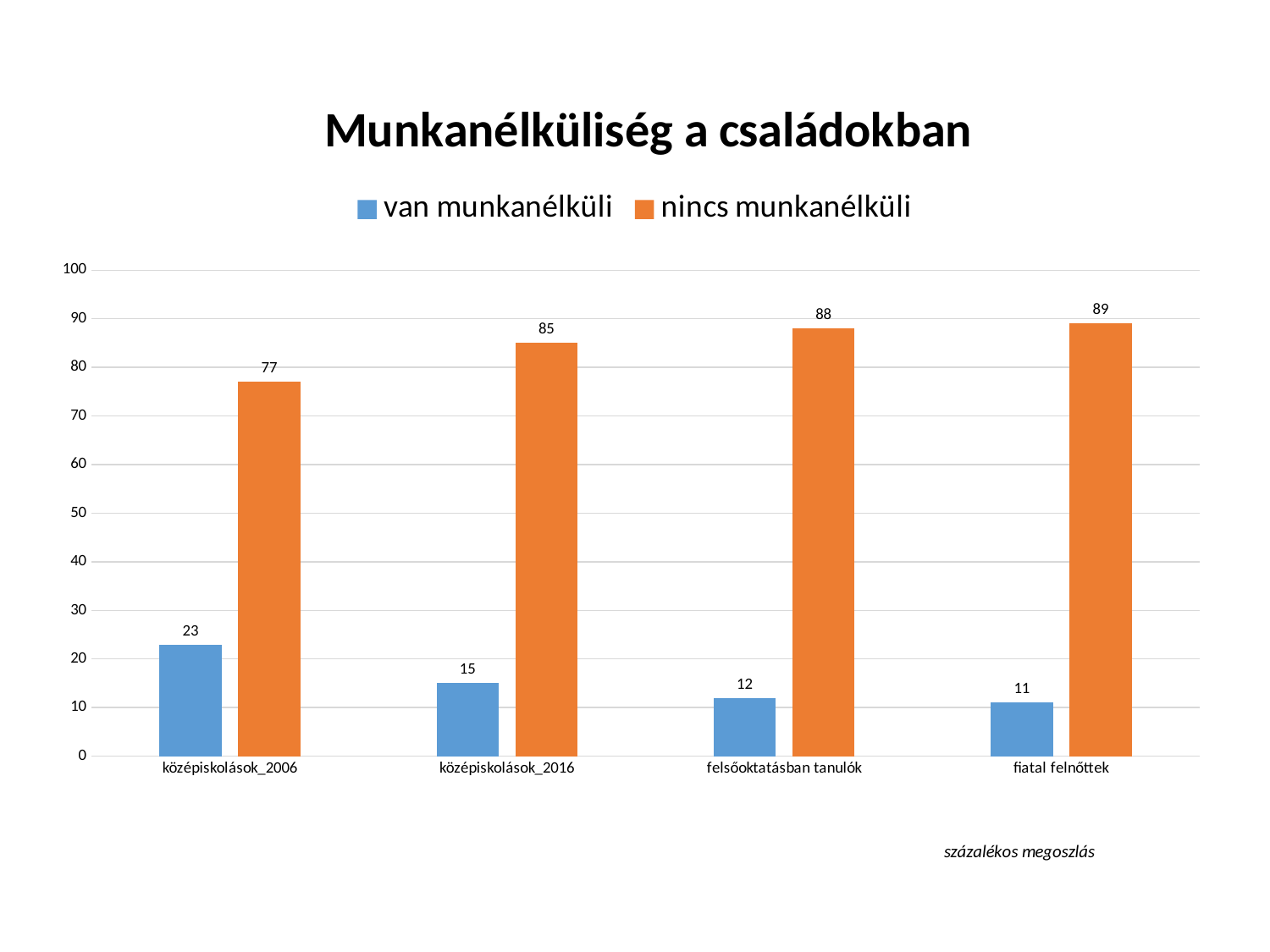
What is the value of "van munkanélküli" for középiskolások_2006? 23 What is the value of "nincs munkanélküli" for felsőoktatásban tanulók? 88 What kind of chart is shown on the slide? bar chart What is the value of "van munkanélküli" for fiatal felnőttek? 11 Which is larger: the "van munkanélküli" value for középiskolások_2006 or for középiskolások_2016? középiskolások_2006 How many series does the legend list? 2 What is the title of the chart? Munkanélküliség a családokban Which category has the highest value for "nincs munkanélküli"? fiatal felnőttek What is the difference between the "nincs munkanélküli" values for középiskolások_2016 and középiskolások_2006? 8 How many categories are shown on the x axis? 4 Do the "van munkanélküli" values rise or fall from left to right along the x axis? fall Which category has the lowest value for "van munkanélküli"? fiatal felnőttek